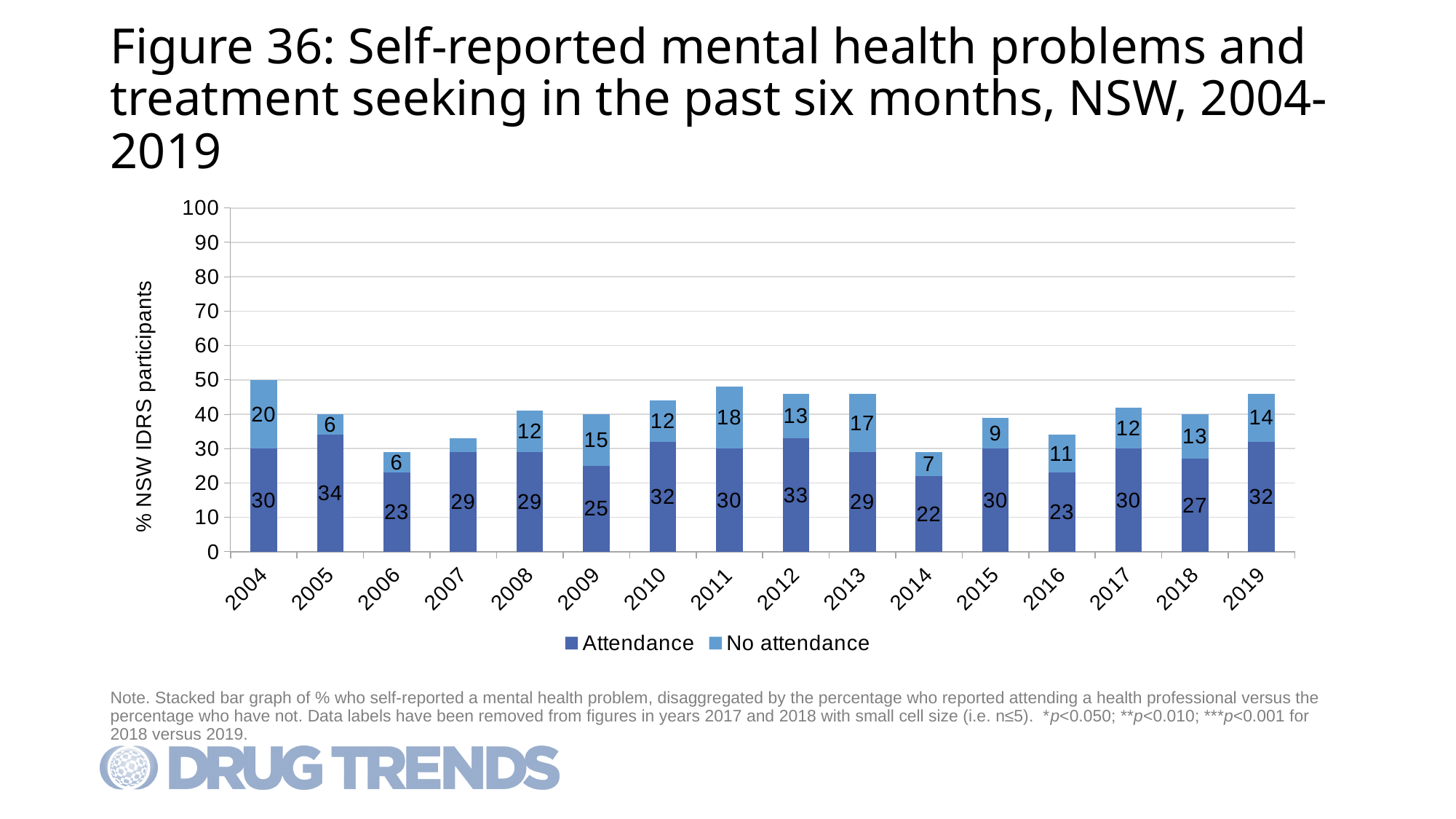
What is the total height of the stacked bar for 2019? 46 What is the total height of the stacked bar for 2004? 50 Which year has the lowest Attendance value? 2014 What is the difference between the Attendance values for 2005 and 2014? 12 How many series does the legend list? 2 What is the Attendance value for 2012? 33 What is the No attendance value for 2011? 18 Which year has the highest No attendance value? 2004 Which is larger, the No attendance value for 2013 or for 2015? 2013 What kind of chart is shown on the slide? Stacked bar chart How many years are shown on the x axis? 16 Which year has the highest Attendance value? 2005